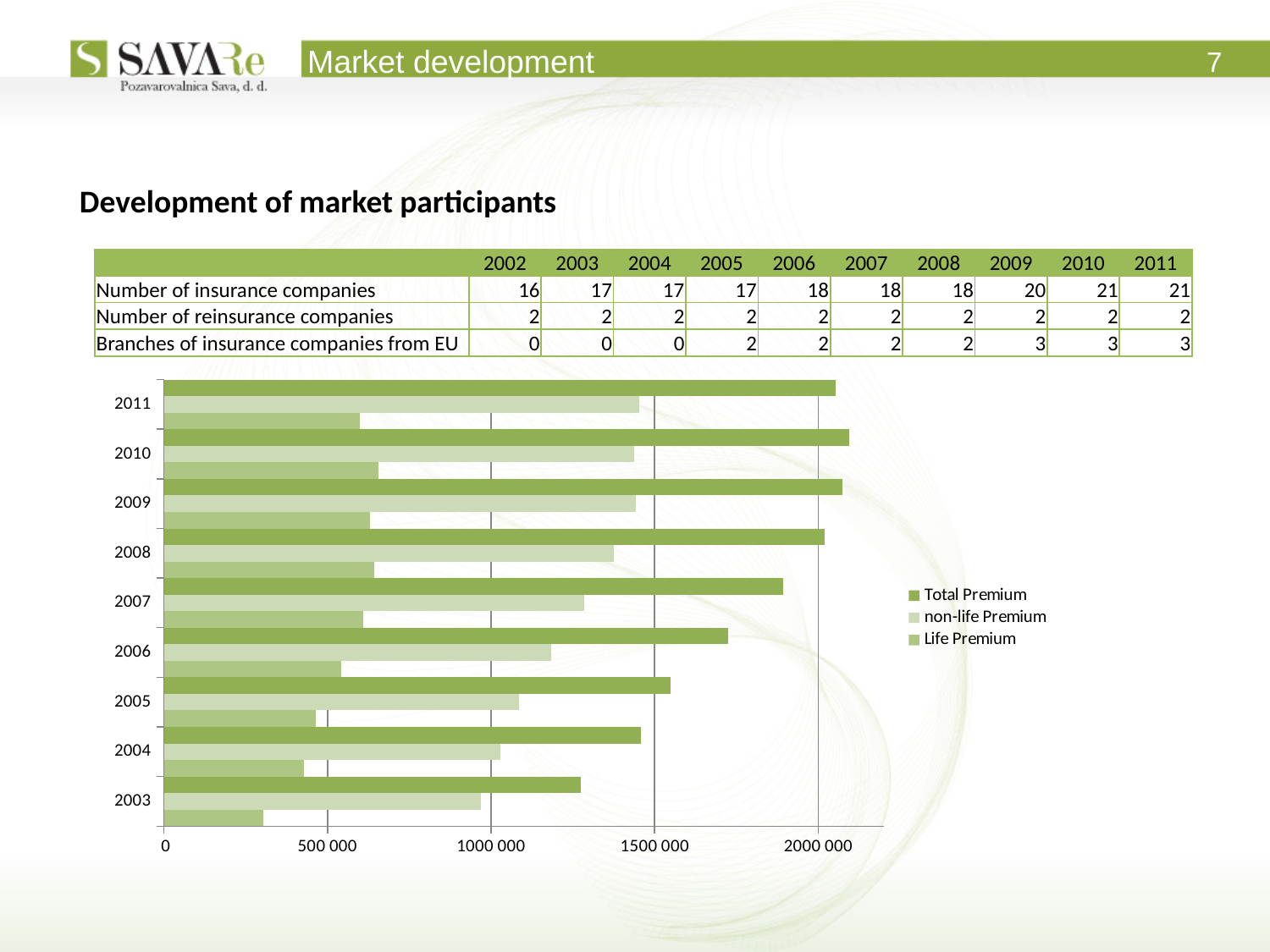
Is the non-life Premium value for 2007 greater or less than 1000 000? greater Is the Total Premium value for 2011 greater or less than 2000 000? greater Is the Total Premium value for 2006 greater or less than 1500 000? greater What kind of chart is shown on the slide? bar chart How many years are shown on the chart's vertical axis? 9 In which year is the Total Premium lowest? 2003 Which year has the larger Total Premium, 2006 or 2007? 2007 How many series does the chart legend list? 3 Which series are listed in the chart legend? Total Premium, non-life Premium, Life Premium Does the Total Premium rise or fall from 2003 to 2010? rise